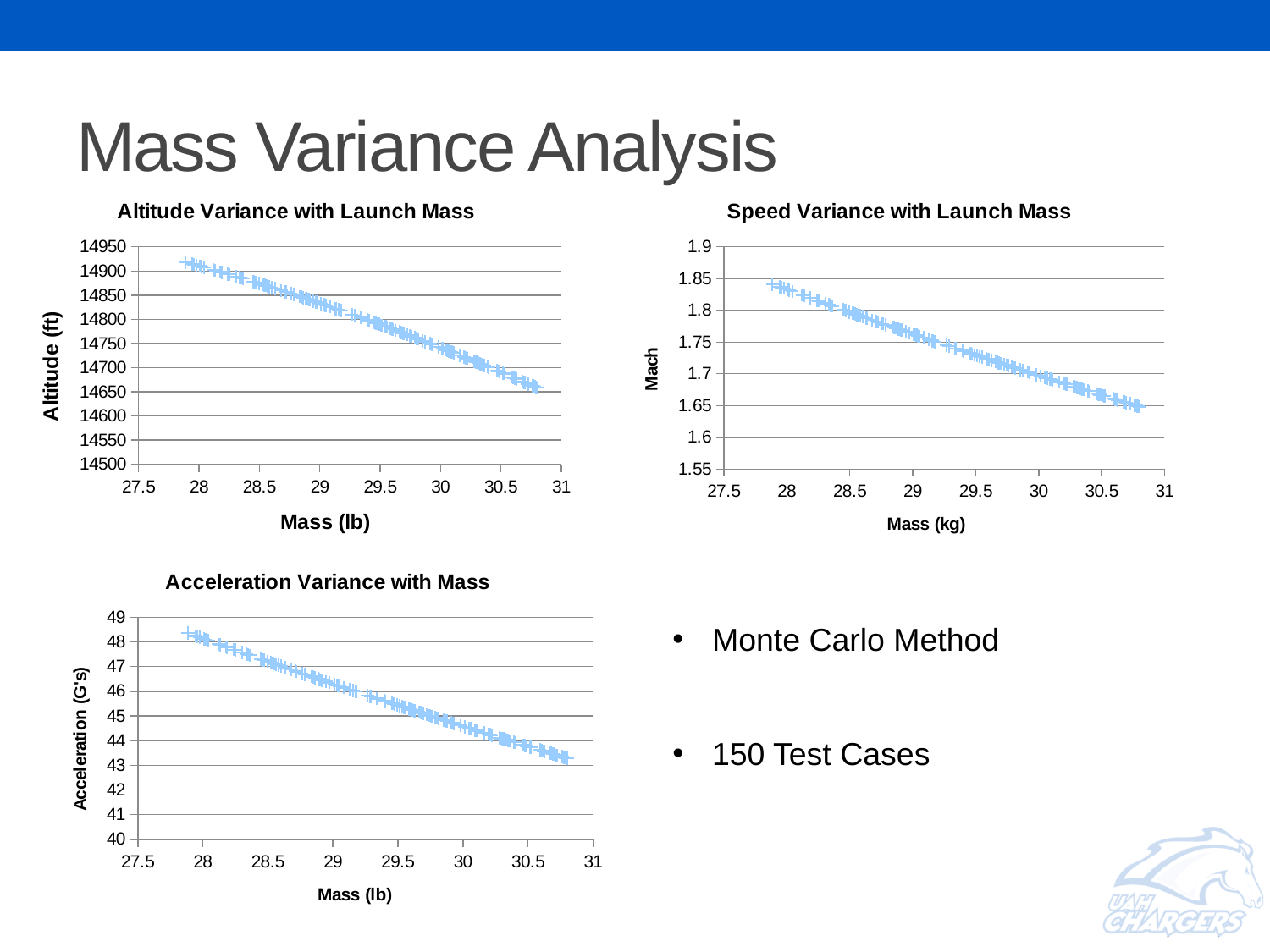
In the 'Altitude Variance with Launch Mass' chart, does altitude rise or fall as mass increases along the x axis? fall What is the y-axis label of the 'Altitude Variance with Launch Mass' chart? Altitude (ft) In the 'Acceleration Variance with Mass' chart, does acceleration rise or fall as mass increases? fall What is the x-axis label of the 'Speed Variance with Launch Mass' chart? Mass (kg) In the 'Acceleration Variance with Mass' chart, is the acceleration at a mass of 28 lb greater or less than 47? greater In the 'Altitude Variance with Launch Mass' chart, is the altitude at a mass of 28 lb greater or less than 14850? greater In the 'Altitude Variance with Launch Mass' chart, is the altitude at a mass of 30.5 lb greater or less than 14750? less In the 'Speed Variance with Launch Mass' chart, does Mach rise or fall as mass increases? fall What kind of chart is the 'Altitude Variance with Launch Mass' chart? scatter chart